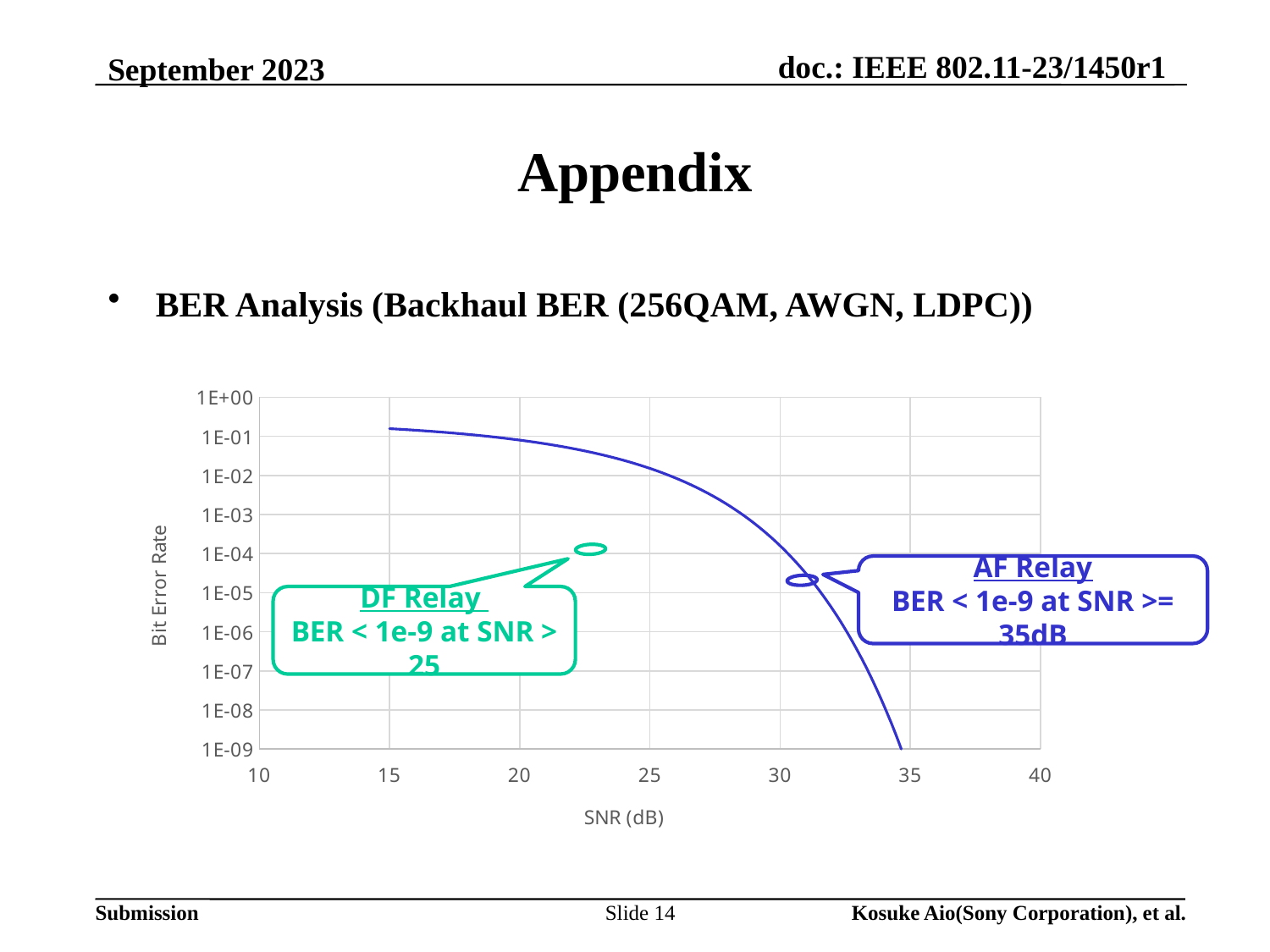
Is the bit error rate at SNR 15 dB greater or less than 1E-02? greater Is the bit error rate at SNR 20 dB greater or less than 1E-02? greater What kind of chart is shown on the slide? line chart How many tick labels are shown on the x axis of the chart? 7 Is the bit error rate at SNR 35 dB greater or less than 1E-08? less What is the label of the y axis of the chart? Bit Error Rate What is the lowest value shown on the y axis of the chart? 1E-09 Does the bit error rate rise or fall as SNR increases along the x axis? fall How many lines are plotted on the chart? 1 Is the bit error rate higher at SNR 15 dB or at SNR 30 dB? 15 dB What is the label of the x axis of the chart? SNR (dB)